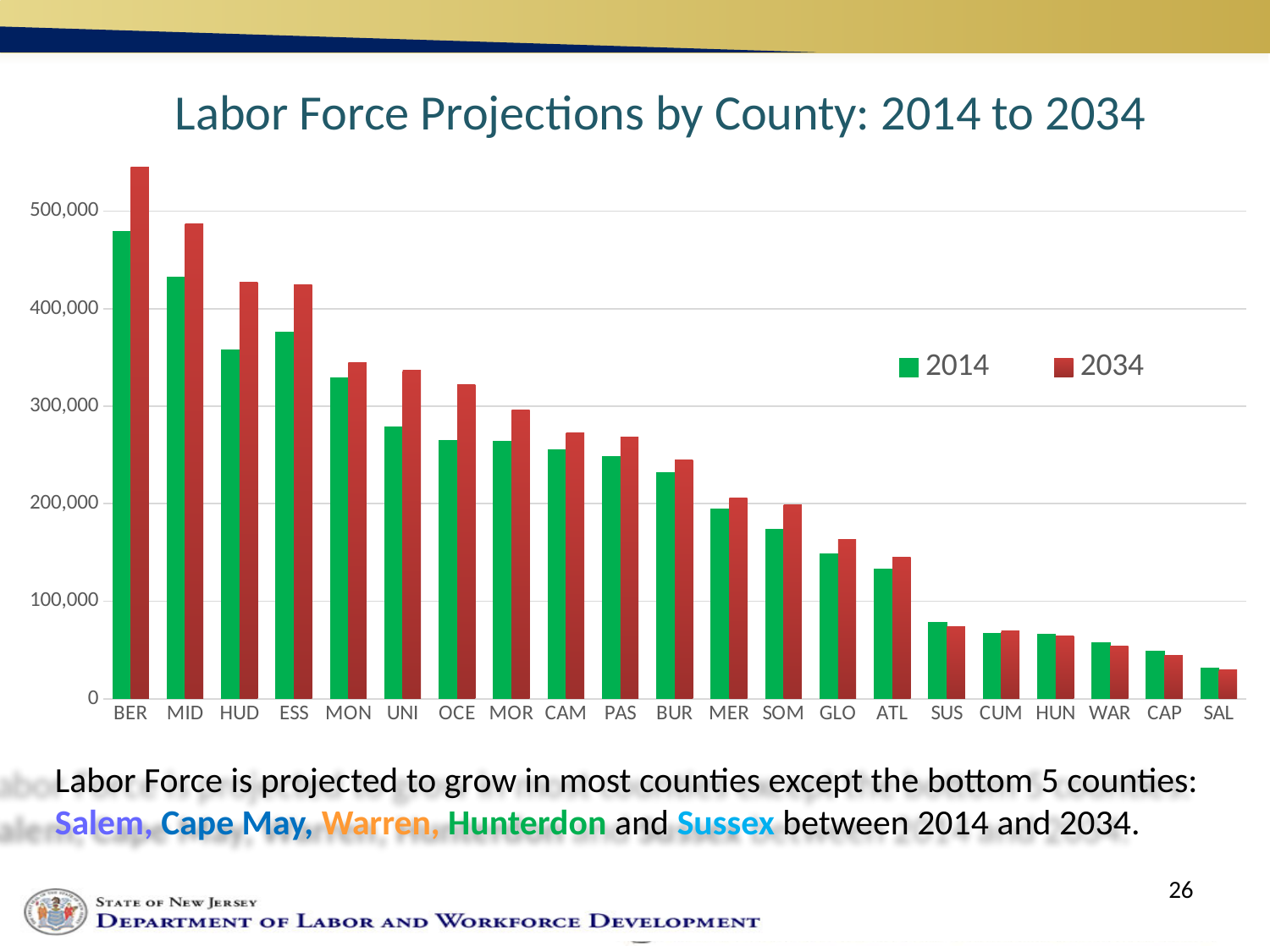
Which is larger, the 2014 value for HUD or the 2014 value for ESS? ESS Which county has the highest 2034 labor force projection? BER For CAP, which is larger, the 2014 value or the 2034 value? 2014 What kind of chart is shown on the slide? bar chart Is the 2014 value for SUS greater or less than 100,000? less Which county has the lowest 2014 labor force value? SAL Do the 2014 values generally rise or fall moving from left to right along the x axis? fall Is the 2014 value for HUD greater or less than 400,000? less Is the 2034 value for BER greater or less than 500,000? greater How many counties are shown on the x axis? 21 How many series does the legend list? 2